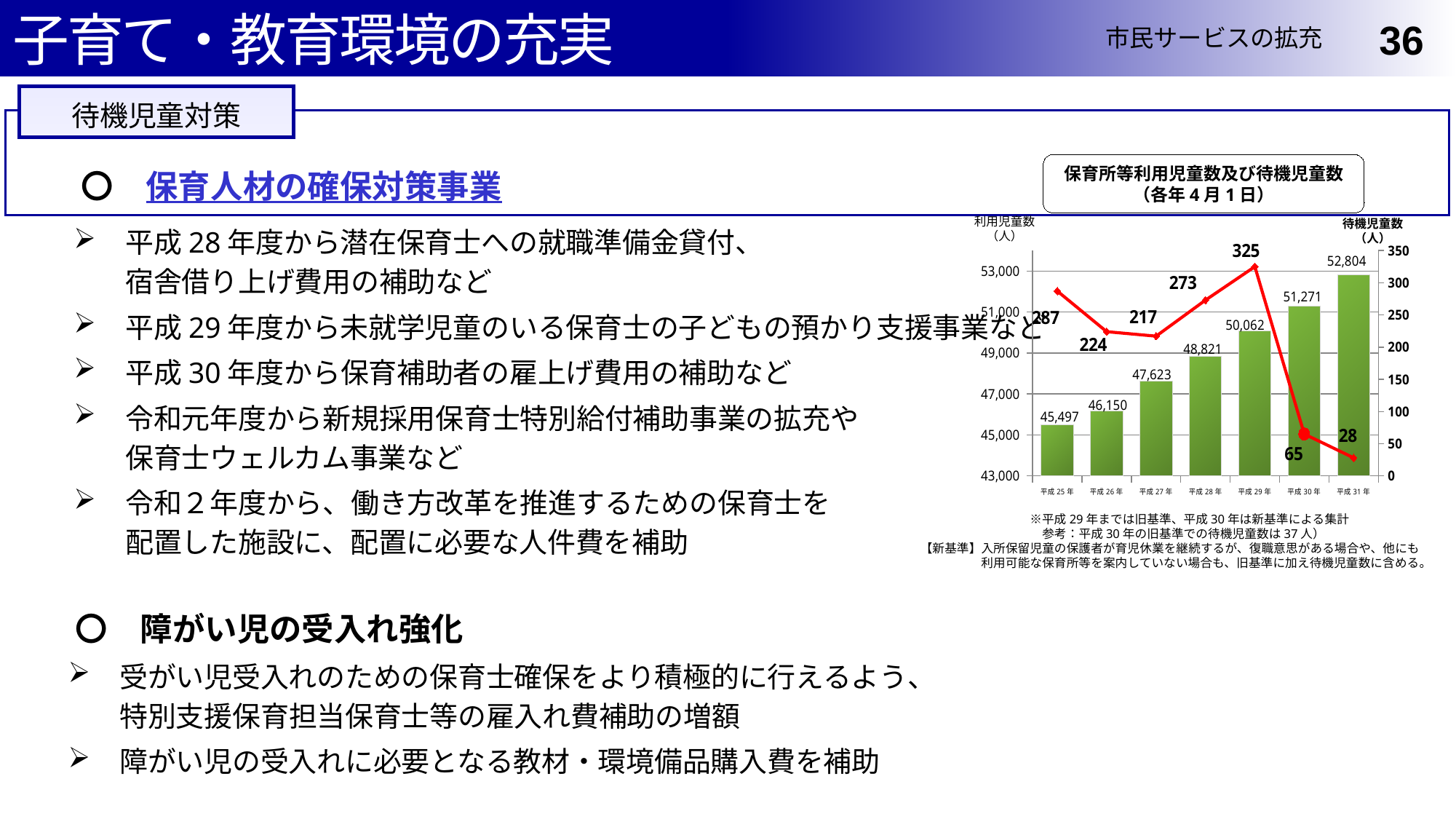
「保育所等利用児童数及び待機児童数」のグラフで、平成31年の利用児童数はいくつですか？ 52,804 「保育所等利用児童数及び待機児童数」のグラフで、待機児童数が最も少ない年はどれですか？ 平成31年 「保育所等利用児童数及び待機児童数」のグラフで、平成25年の利用児童数はいくつですか？ 45,497 「保育所等利用児童数及び待機児童数」のグラフで、利用児童数が最も多い年はどれですか？ 平成31年 「保育所等利用児童数及び待機児童数」のグラフで、平成26年と平成27年では、待機児童数が多いのはどちらですか？ 平成26年 「保育所等利用児童数及び待機児童数」のグラフには、何年分のデータが示されていますか？ 7 「保育所等利用児童数及び待機児童数」のグラフで、平成29年の待機児童数はいくつですか？ 325 「保育所等利用児童数及び待機児童数」のグラフで、平成29年と平成30年の待機児童数の差はいくつですか？ 260 「保育所等利用児童数及び待機児童数」のグラフで、利用児童数はどのような種類のグラフで示されていますか？ 棒グラフ 「保育所等利用児童数及び待機児童数」のグラフで、待機児童数が最も多い年はどれですか？ 平成29年 「保育所等利用児童数及び待機児童数」のグラフで、利用児童数は平成25年から平成31年にかけて増加していますか、減少していますか？ 増加 「保育所等利用児童数及び待機児童数」のグラフで、平成31年と平成25年の利用児童数の差はいくつですか？ 7,307